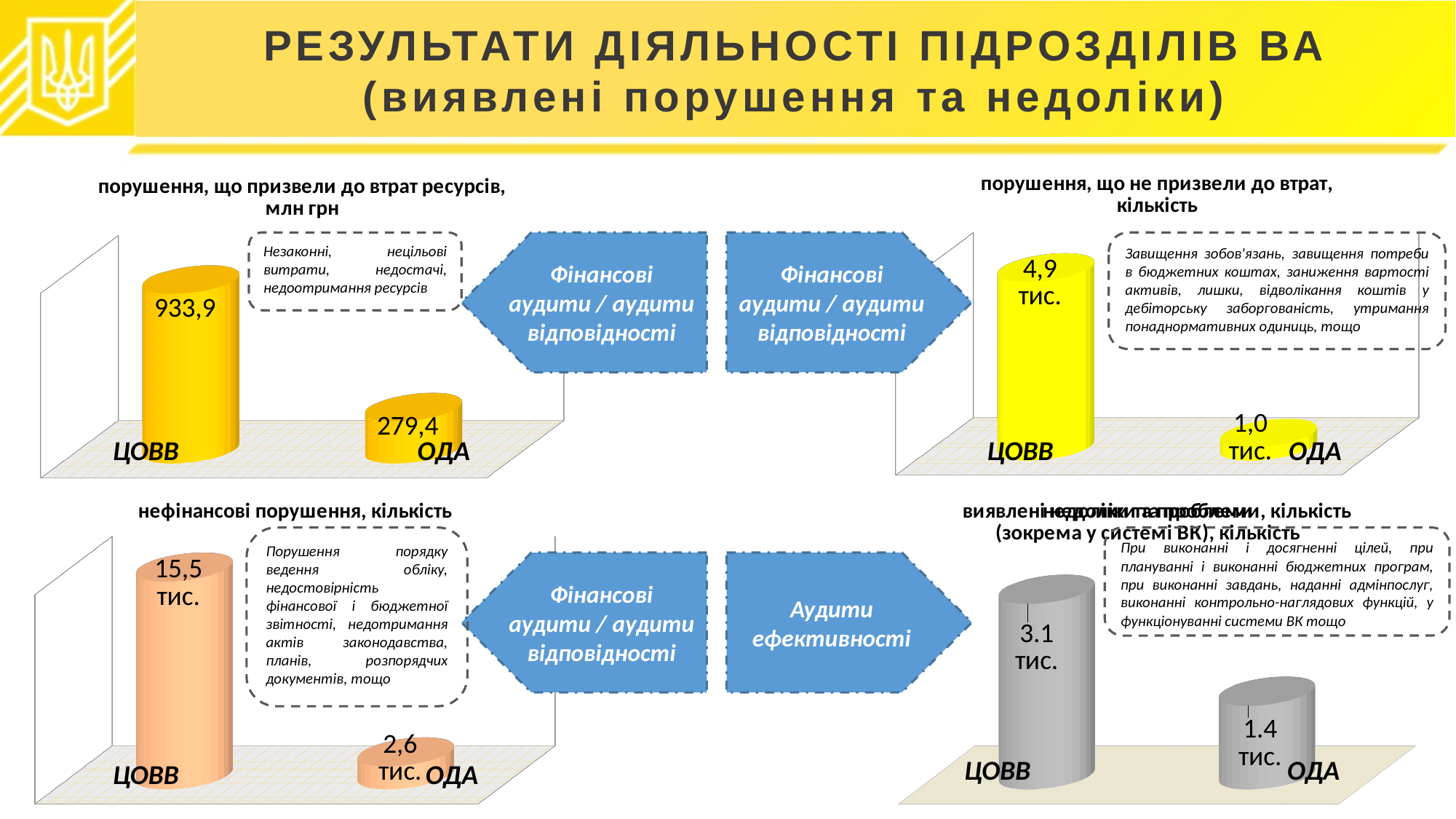
In the bottom-left chart (нефінансові порушення, кількість), what is the difference between the ЦОВВ and ОДА values? 12,9 тис. In the bottom-left chart (нефінансові порушення, кількість), what is the value for ОДА? 2,6 тис. In the top-right chart (порушення, що не призвели до втрат, кількість), what is the value for ОДА? 1,0 тис. How many categories does the top-left chart (порушення, що призвели до втрат ресурсів, млн грн) show? 2 In the bottom-left chart (нефінансові порушення, кількість), what is the value for ЦОВВ? 15,5 тис. In the top-left chart (порушення, що призвели до втрат ресурсів, млн грн), what is the value for ОДА? 279,4 In the top-left chart (порушення, що призвели до втрат ресурсів, млн грн), what is the value for ЦОВВ? 933,9 In the bottom-right chart, what is the value for ОДА? 1.4 тис. In the top-right chart (порушення, що не призвели до втрат, кількість), which category has the higher value? ЦОВВ In the top-left chart (порушення, що призвели до втрат ресурсів, млн грн), what is the difference between the ЦОВВ and ОДА values? 654,5 In the top-right chart (порушення, що не призвели до втрат, кількість), what is the value for ЦОВВ? 4,9 тис. In the bottom-right chart, what is the value for ЦОВВ? 3.1 тис.